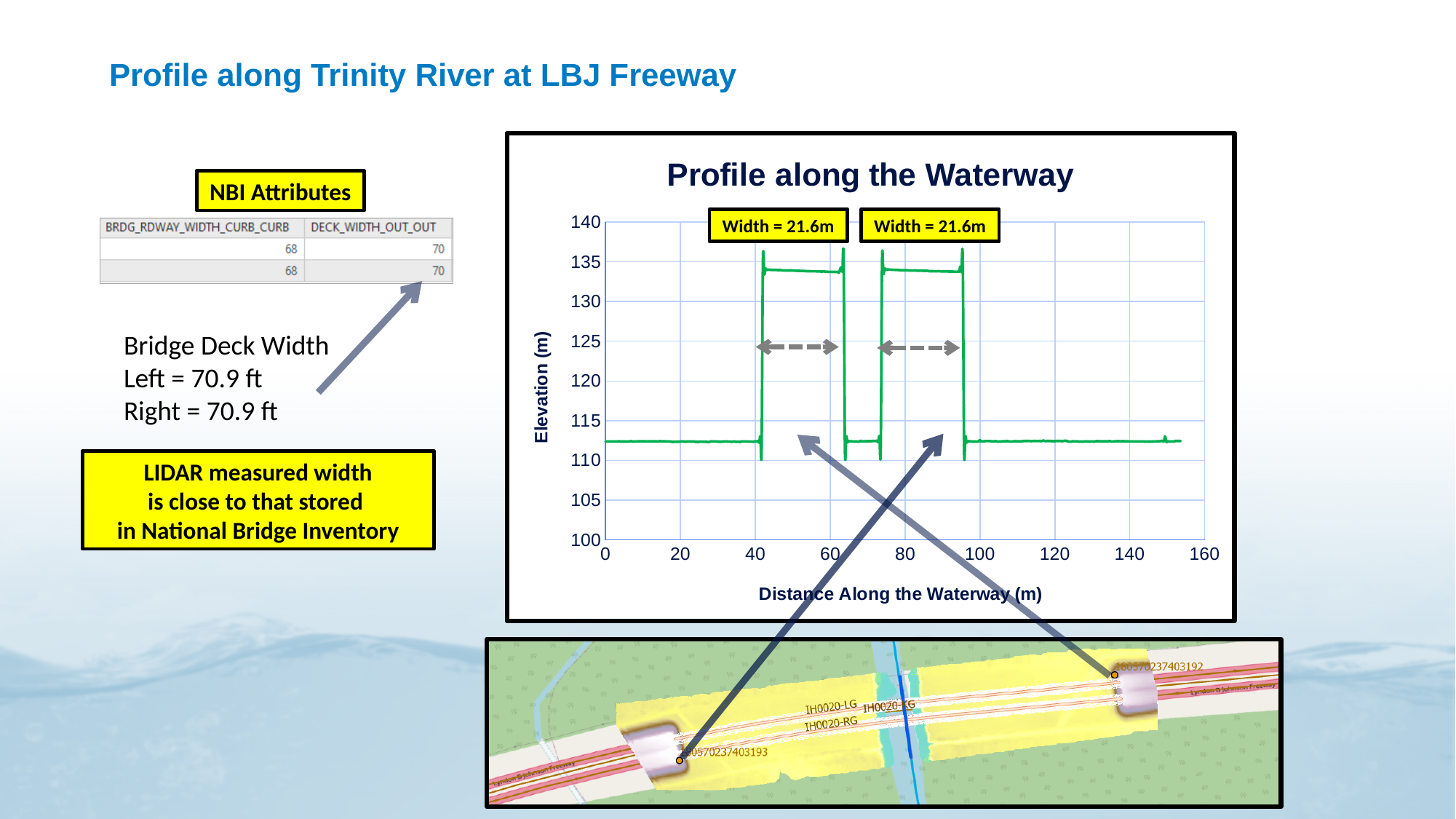
In the 'Profile along the Waterway' chart, how many raised bridge-deck plateaus does the profile line show? 2 In the 'Profile along the Waterway' chart, what width is given in the annotation above the first bridge deck? Width = 21.6m In the 'Profile along the Waterway' chart, is the elevation at a distance of 85 m greater or less than 125? greater In the 'Profile along the Waterway' chart, is the elevation at a distance of 120 m greater or less than 110? greater In the 'Profile along the Waterway' chart, is the elevation at a distance of 50 m greater or less than 130? greater In the 'Profile along the Waterway' chart, what width is given in the annotation above the second bridge deck? Width = 21.6m What is the title of the chart on the slide? Profile along the Waterway In the 'Profile along the Waterway' chart, what is the maximum value shown on the x axis? 160 What is the label of the x axis of the 'Profile along the Waterway' chart? Distance Along the Waterway (m) In the 'Profile along the Waterway' chart, which is higher: the elevation at a distance of 50 m or the elevation at a distance of 10 m? 50 m What kind of chart is shown in the 'Profile along the Waterway' chart? line chart